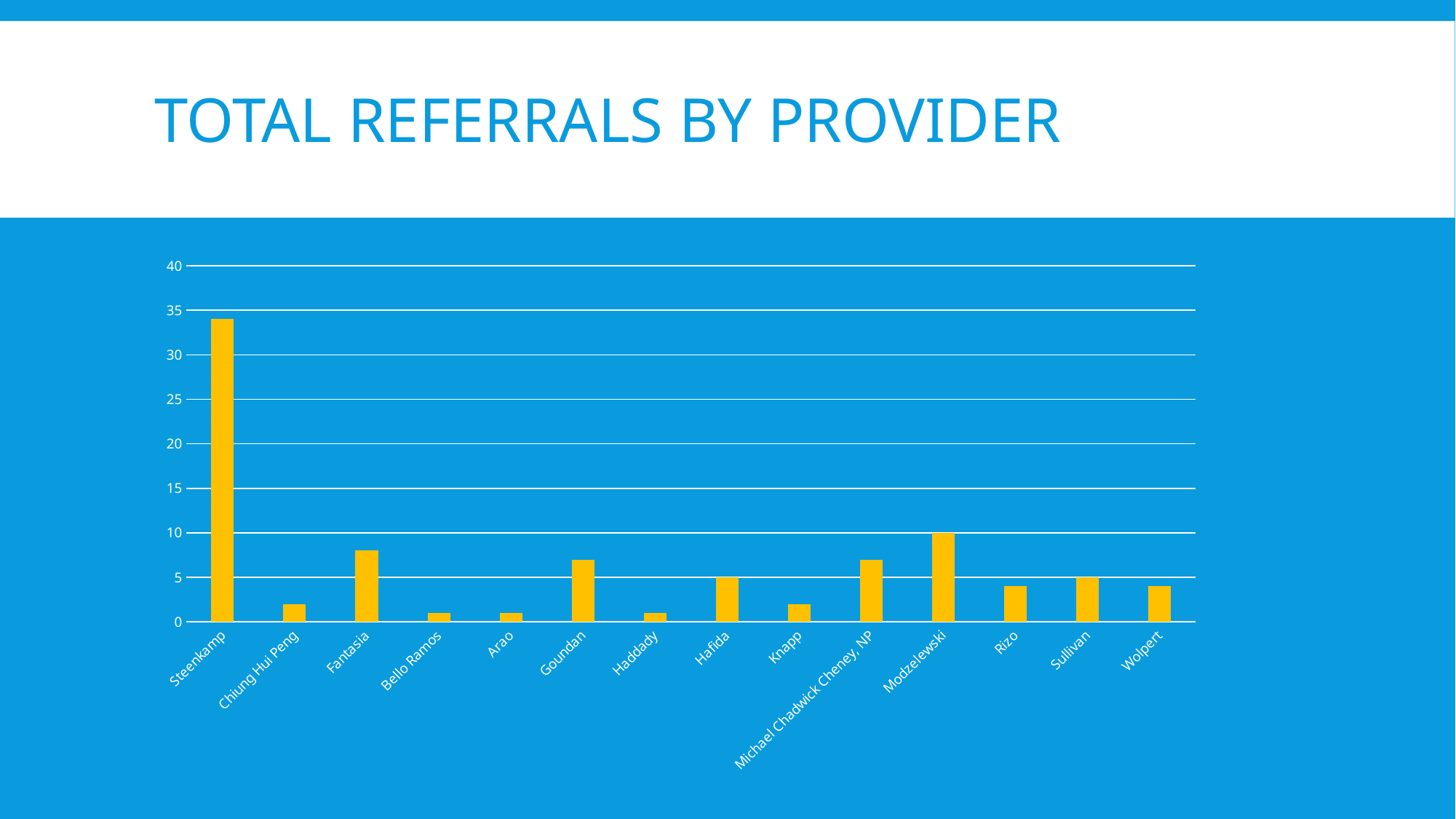
Is the value for Fantasia greater or less than 5? greater Which has more referrals, Steenkamp or Modzelewski? Steenkamp What is the value for Modzelewski? 10 Is the value for Chiung Hui Peng greater or less than 5? less Which provider has the highest number of referrals? Steenkamp Is the value for Goundan greater or less than 10? less Which has more referrals, Fantasia or Knapp? Fantasia What is the title of the chart? Total Referrals by Provider What type of chart is shown on the slide? Bar chart What is the value for Hafida? 5 How many providers are shown on the x axis of the chart? 14